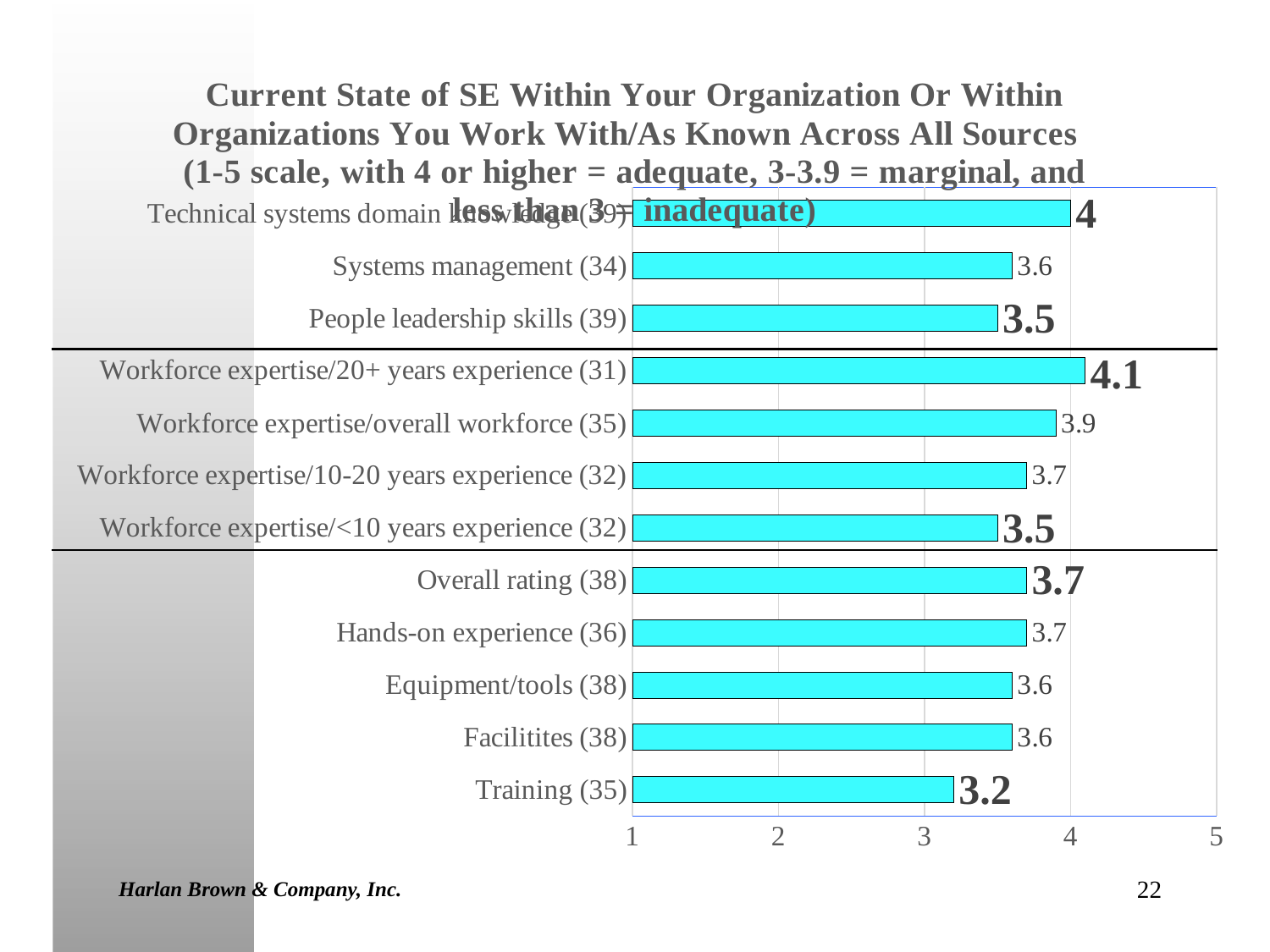
What is the difference between the values for Facilitites (38) and Training (35)? 0.4 Is the value for People leadership skills (39) greater or less than 4? less Which category has the highest value? Workforce expertise/20+ years experience (31) What is the value for Workforce expertise/overall workforce (35)? 3.9 Which category has the lowest value? Training (35) What is the value for Systems management (34)? 3.6 What is the value for Overall rating (38)? 3.7 How many categories are shown in the chart? 12 Which is larger, the value for Hands-on experience (36) or the value for Equipment/tools (38)? Hands-on experience (36) What kind of chart is shown on the slide? Bar chart What is the value for Training (35)? 3.2 What is the difference between the values for Workforce expertise/20+ years experience (31) and Workforce expertise/<10 years experience (32)? 0.6